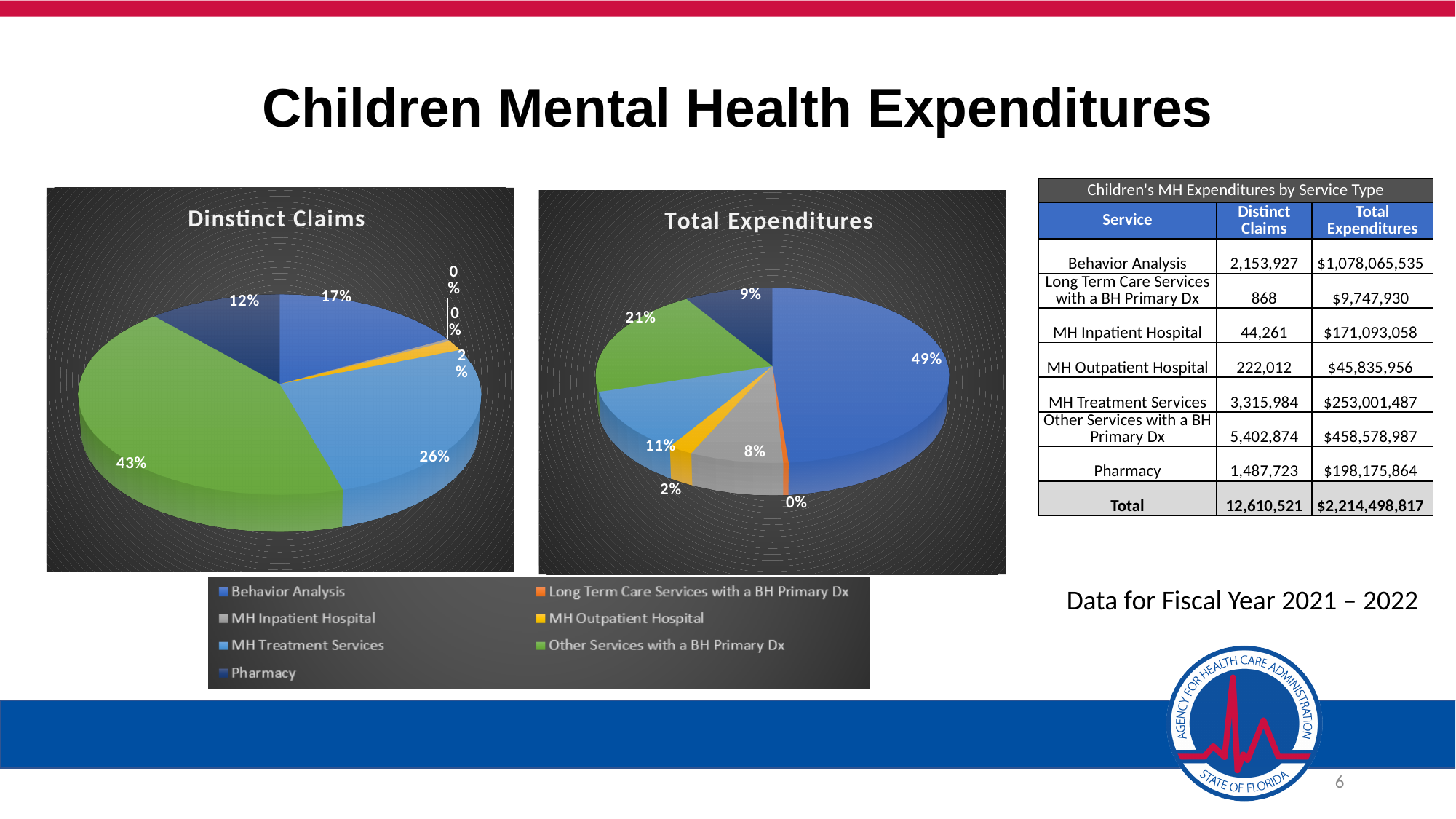
In the "Dinstinct Claims" pie chart, what share does MH Treatment Services have? 26% How many entries does the shared legend below the pie charts list? 7 What kind of chart is the "Dinstinct Claims" chart? pie chart In the "Dinstinct Claims" pie chart, what share does Pharmacy have? 12% In the "Total Expenditures" pie chart, what is the difference in percentage points between the Behavior Analysis slice and the Other Services with a BH Primary Dx slice? 28 percentage points In the "Total Expenditures" pie chart, which is larger: the MH Treatment Services slice or the Pharmacy slice? MH Treatment Services In the "Total Expenditures" pie chart, what share does Behavior Analysis have? 49% In the "Total Expenditures" pie chart, which category has the largest slice? Behavior Analysis In the "Dinstinct Claims" pie chart, which category has the largest slice? Other Services with a BH Primary Dx